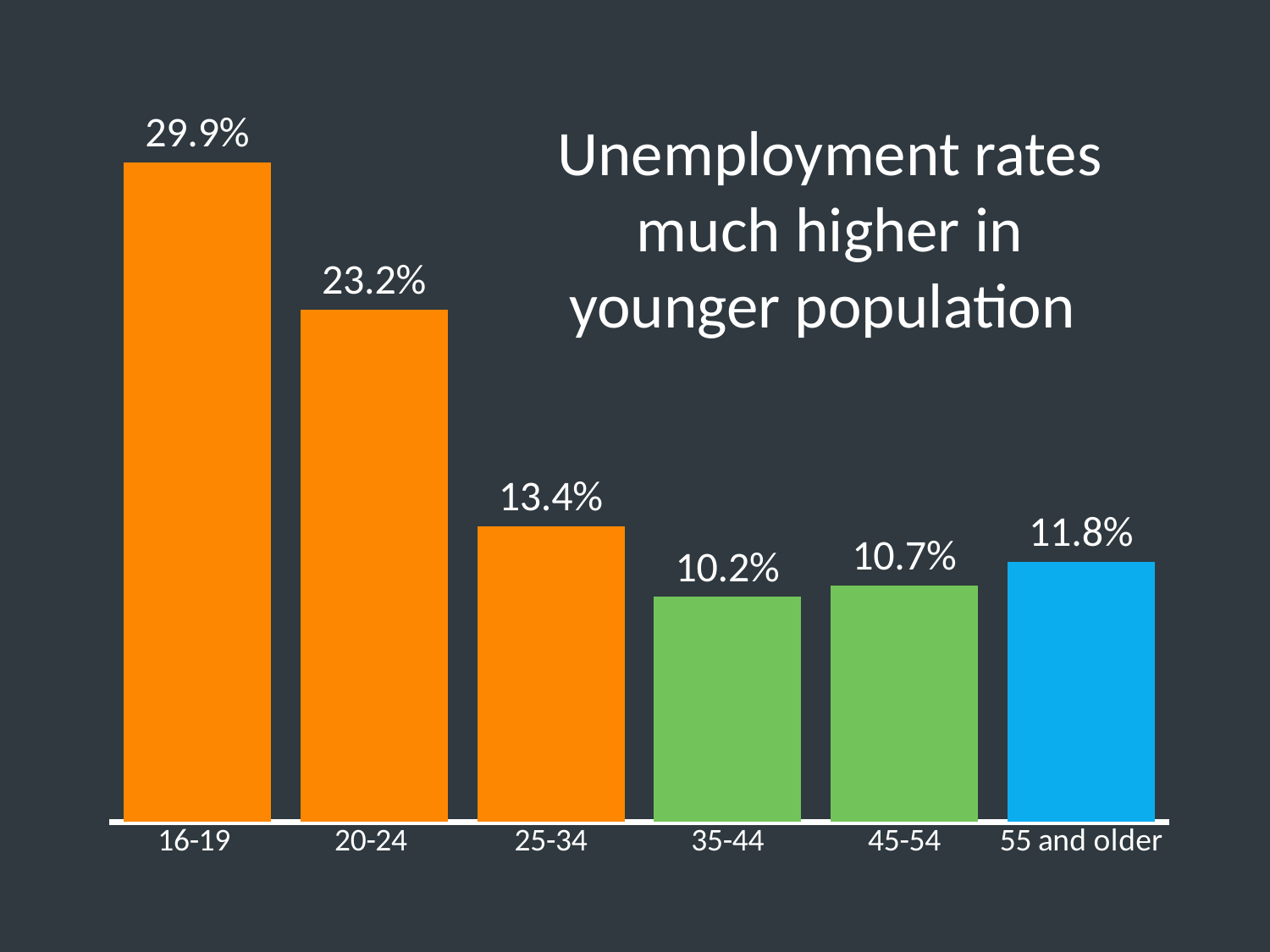
Which age group has the lowest unemployment rate? 35-44 What is the difference in unemployment rate between the 25-34 and 35-44 age groups? 3.2% What is the difference in unemployment rate between the 16-19 and 20-24 age groups? 6.7% Do the unemployment rates generally rise or fall from the 16-19 group to the 35-44 group? Fall Which has a higher unemployment rate, the 45-54 group or the 55 and older group? 55 and older What is the unemployment rate for the 35-44 age group? 10.2% What colour are the bars for the 35-44 and 45-54 age groups? Green What is the unemployment rate for the 55 and older age group? 11.8% What kind of chart is shown on the slide? Bar chart How many age groups are shown in the chart? 6 Which age group has the highest unemployment rate? 16-19 What is the unemployment rate for the 16-19 age group? 29.9%